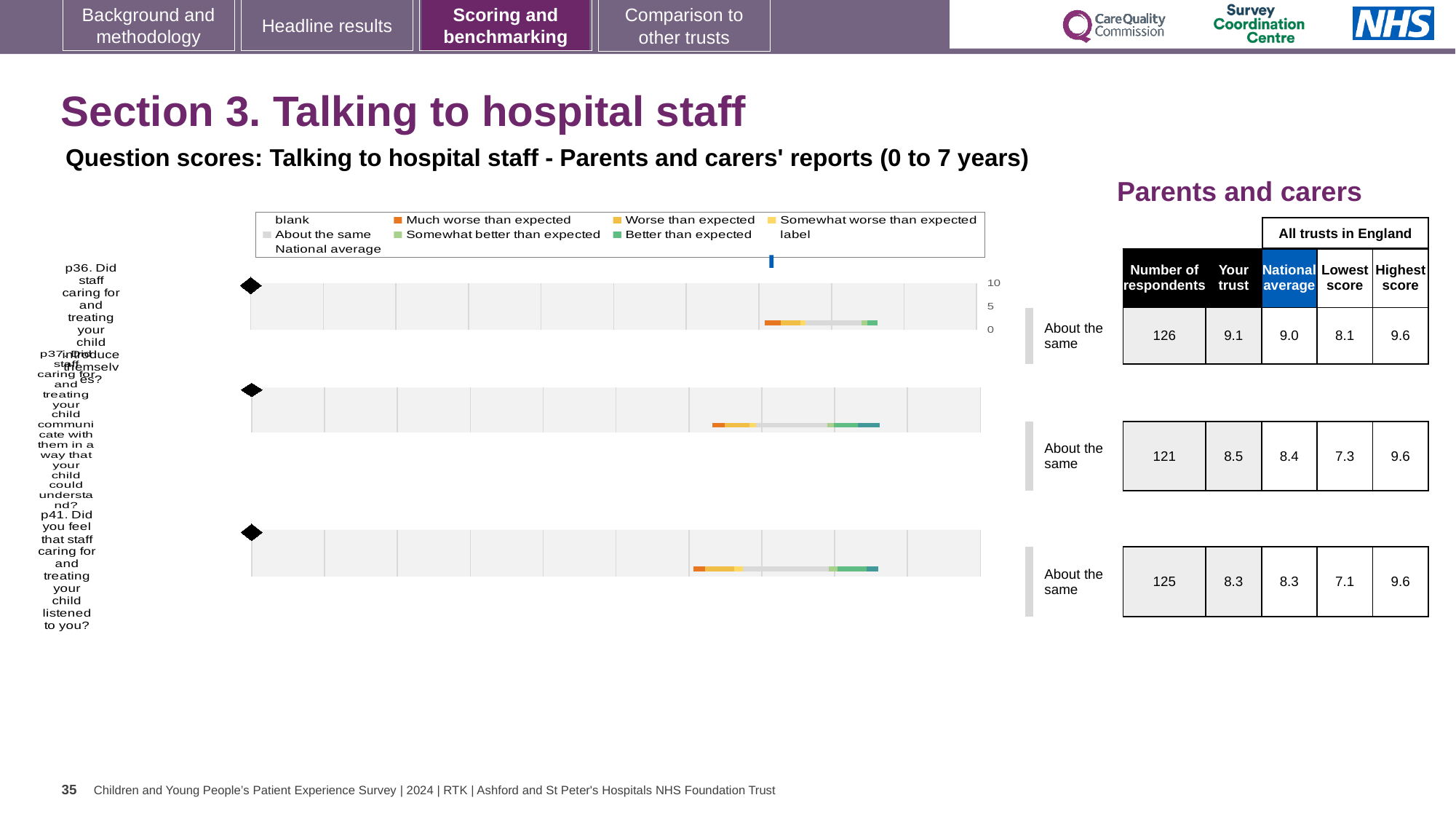
Which question has the lowest 'Your trust' score? p41 What is the maximum value shown on the chart's score axis? 10 How many respondents answered p41 (Did you feel that staff listened to you?)? 125 How many questions (categories) are plotted in the chart? 3 What is the 'Your trust' score for p36 (Did staff caring for and treating your child introduce themselves?)? 9.1 In the chart legend, what colour represents 'Much worse than expected'? Orange What is the national average score for p37 (Did staff communicate with your child in a way they could understand?)? 8.4 What is the highest score among all trusts in England for p36? 9.6 What kind of chart is used to show the question scores on this slide? Bar chart Which question has the highest 'Your trust' score? p36 For p37, which is larger: the 'Your trust' score or the national average? Your trust What is the difference between the 'Your trust' score and the national average for p36? 0.1